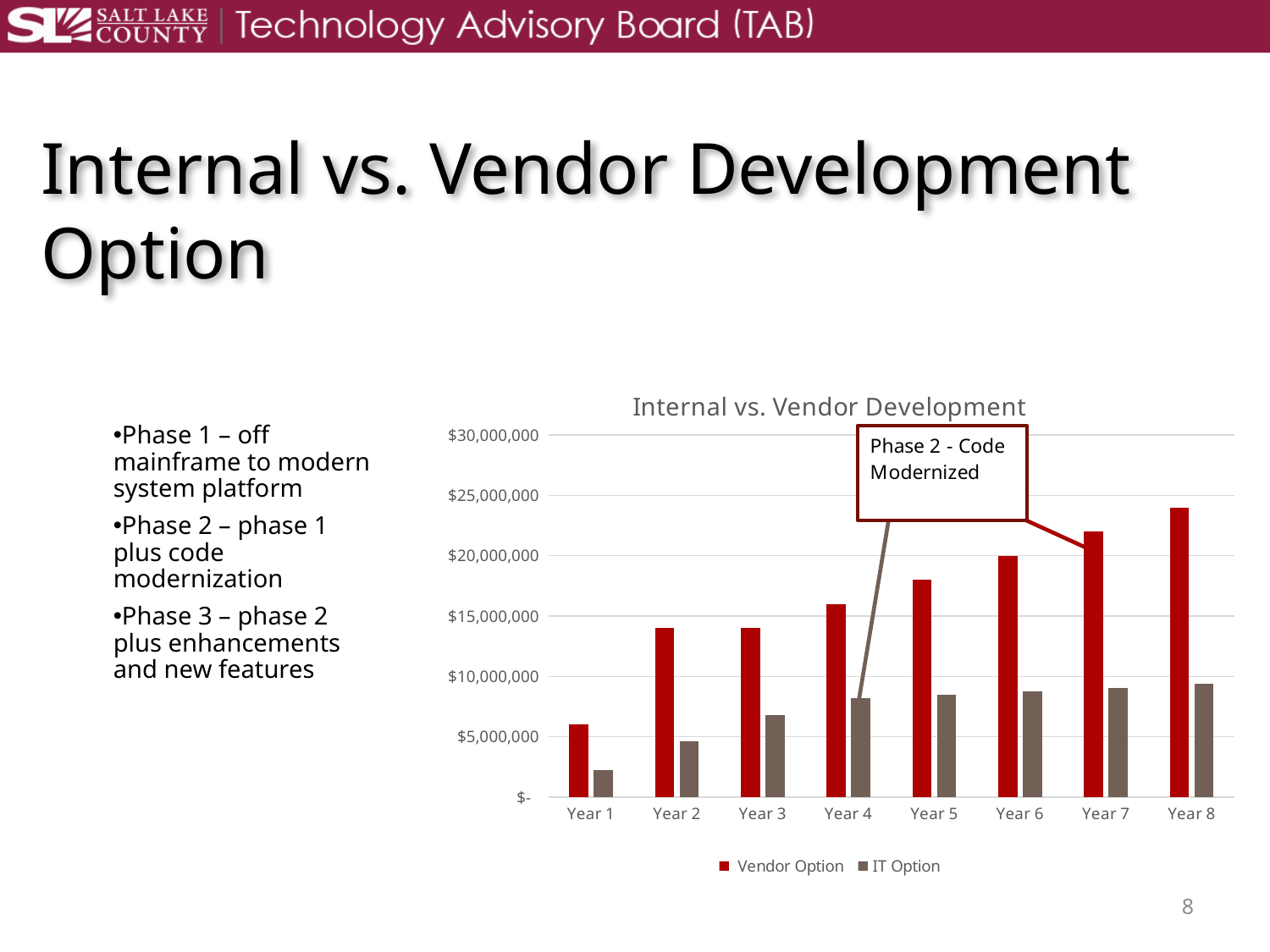
What kind of chart is shown on the slide? Bar chart In which year is the Vendor Option value lowest? Year 1 Is the Vendor Option value for Year 8 greater or less than $20,000,000? greater Is the IT Option value for Year 1 greater or less than $5,000,000? less How many series does the legend of the chart list? 2 Is the Vendor Option value for Year 2 greater or less than $10,000,000? greater Do the Vendor Option values generally rise or fall from Year 1 to Year 8? Rise In Year 4, which is larger: the Vendor Option or the IT Option? Vendor Option What is the title of the chart? Internal vs. Vendor Development In which year is the IT Option value lowest? Year 1 How many years are shown on the x axis of the chart? 8 In which year is the Vendor Option value highest? Year 8